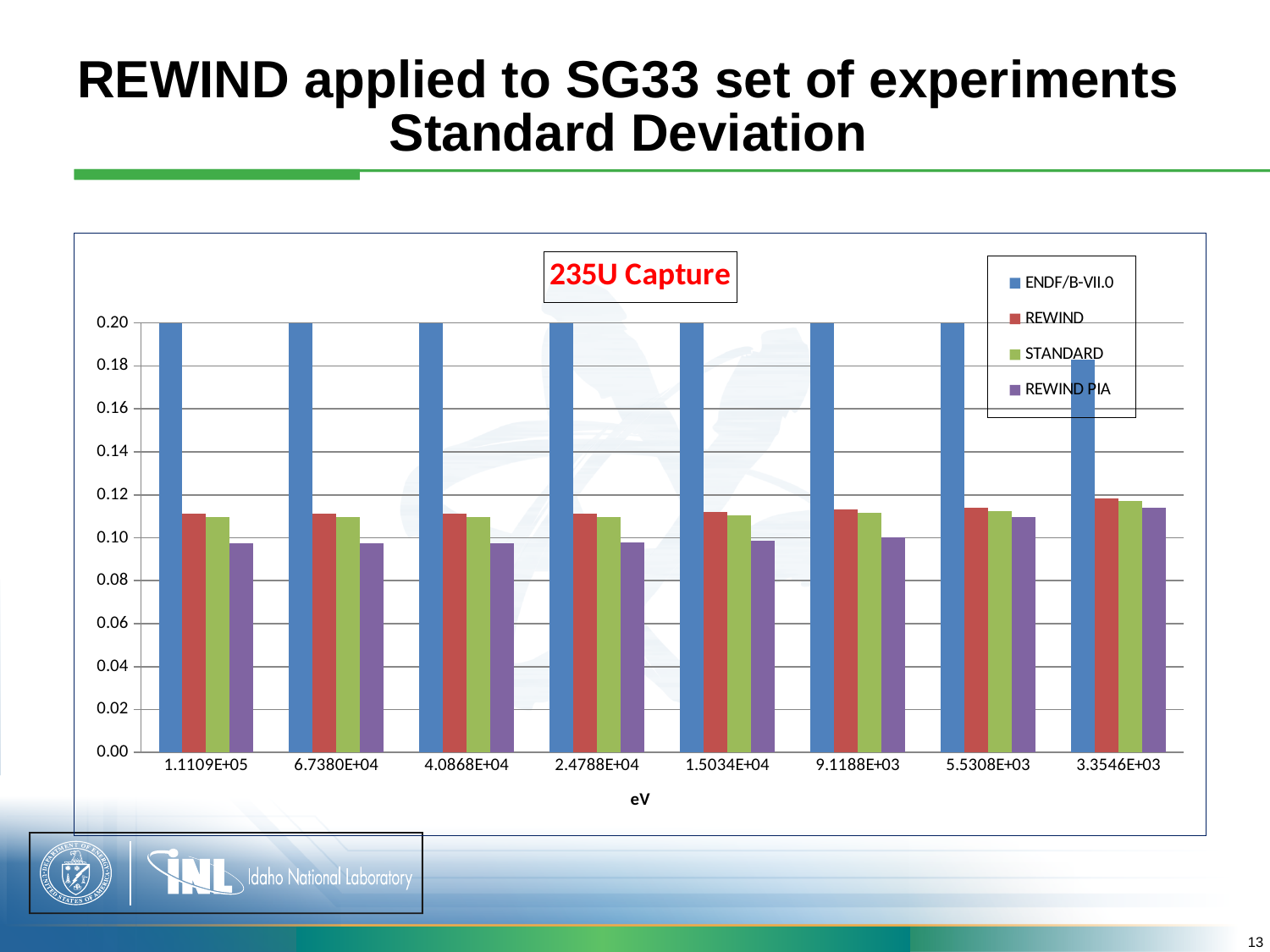
What is the title shown on the chart? 235U Capture Which series has the lowest value at 1.1109E+05 eV? REWIND PIA Is the value for REWIND at 6.7380E+04 eV greater or less than 0.10? greater What is the value for ENDF/B-VII.0 at 1.1109E+05 eV? 0.20 Which series has the highest value at 1.1109E+05 eV? ENDF/B-VII.0 How many energy categories are shown on the x axis? 8 What kind of chart is shown on the slide? bar chart How many series does the legend list? 4 Is the value for REWIND PIA at 1.1109E+05 eV greater or less than 0.10? less Do the REWIND PIA values rise or fall moving from 1.1109E+05 eV to 3.3546E+03 eV along the x axis? rise Which is larger at 2.4788E+04 eV, ENDF/B-VII.0 or REWIND? ENDF/B-VII.0 Is the value for ENDF/B-VII.0 at 3.3546E+03 eV greater or less than 0.20? less